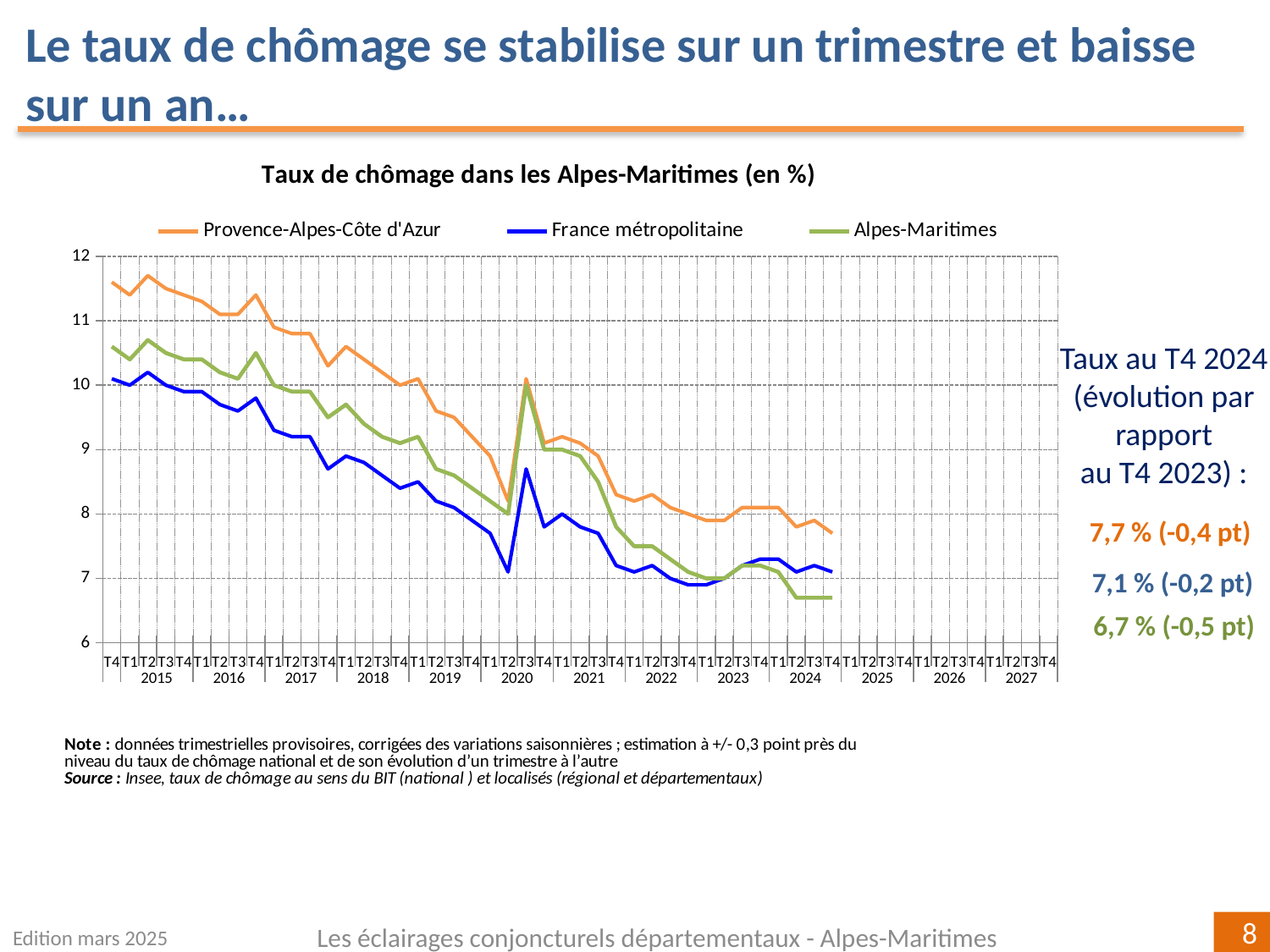
What is the title of the chart? Taux de chômage dans les Alpes-Maritimes (en %) What is the unemployment rate for France métropolitaine at T4 2024? 7,1 % Which series has the lowest value at T4 2024? Alpes-Maritimes What is the unemployment rate for Provence-Alpes-Côte d'Azur at T4 2024? 7,7 % How many series does the legend list? 3 What is the difference between the Provence-Alpes-Côte d'Azur rate and the Alpes-Maritimes rate at T4 2024? 1,0 pt What kind of chart is shown on the slide? line chart What is the unemployment rate for Alpes-Maritimes at T4 2024? 6,7 % Overall, do the unemployment rates rise or fall between 2015 and 2024? fall By how much did the Alpes-Maritimes rate change between T4 2023 and T4 2024, as printed on the slide? -0,5 pt Is the value for Provence-Alpes-Côte d'Azur at T2 2015 greater or less than 11? greater Which series has the highest value at T4 2024? Provence-Alpes-Côte d'Azur